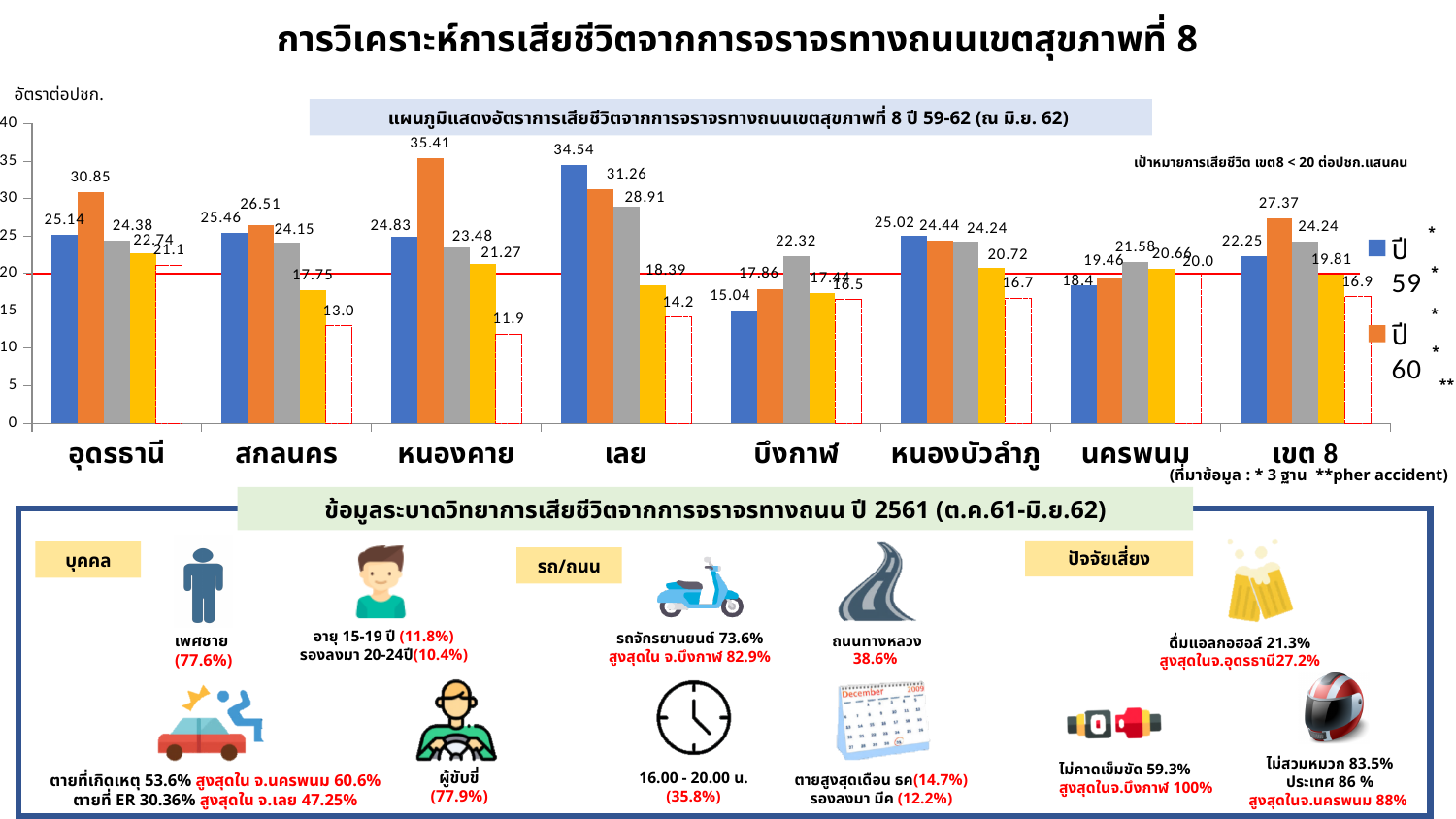
At what value on the y axis is the red horizontal target line drawn in the bar chart? 20 What kind of chart is shown at the top of the slide? bar chart In the bar chart, what is the value for เขต 8 in the ปี 60 series? 27.37 In the bar chart, which category has the highest value in the ปี 59 series? เลย In the bar chart, which category has the highest value in the ปี 60 series? หนองคาย In the bar chart, what is the value for หนองคาย in the ปี 60 series? 35.41 In the bar chart, which category has the lowest value in the ปี 59 series? บึงกาฬ In the bar chart, for อุดรธานี, which is larger: the ปี 59 value or the ปี 60 value? ปี 60 In the bar chart, what is the difference between the ปี 59 and ปี 60 values for เลย? 3.28 In the bar chart, what is the difference between the ปี 60 and ปี 59 values for หนองคาย? 10.58 In the bar chart, what is the value for เลย in the ปี 59 series? 34.54 How many categories are shown on the x axis of the bar chart? 8